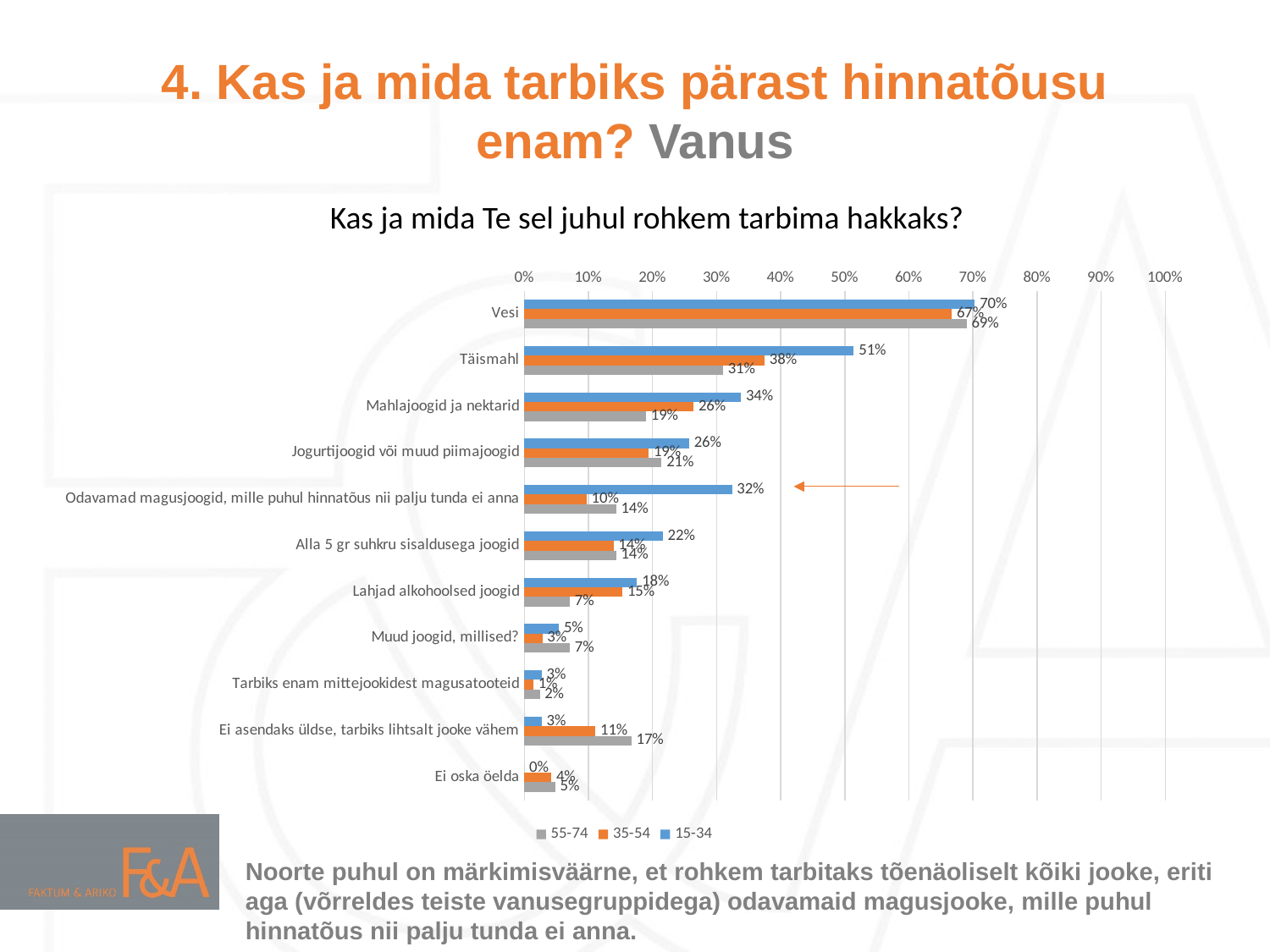
Which category has the highest value in the 15-34 series? Vesi What kind of chart is shown on the slide? Bar chart How many categories are shown on the chart? 11 What is the value for Täismahl in the 15-34 series? 51% What is the value for 'Ei oska öelda' in the 15-34 series? 0% Is the value for Vesi in the 35-54 series greater or less than 60%? greater For 'Odavamad magusjoogid, mille puhul hinnatõus nii palju tunda ei anna', which series has the larger value: 15-34 or 55-74? 15-34 What is the value for 'Ei asendaks üldse, tarbiks lihtsalt jooke vähem' in the 55-74 series? 17% How many series does the legend list? 3 What is the value for 'Odavamad magusjoogid, mille puhul hinnatõus nii palju tunda ei anna' in the 15-34 series? 32% What is the difference between the 15-34 and 55-74 values for Täismahl? 20 percentage points Which category has the lowest value in the 35-54 series? Tarbiks enam mittejookidest magusatooteid